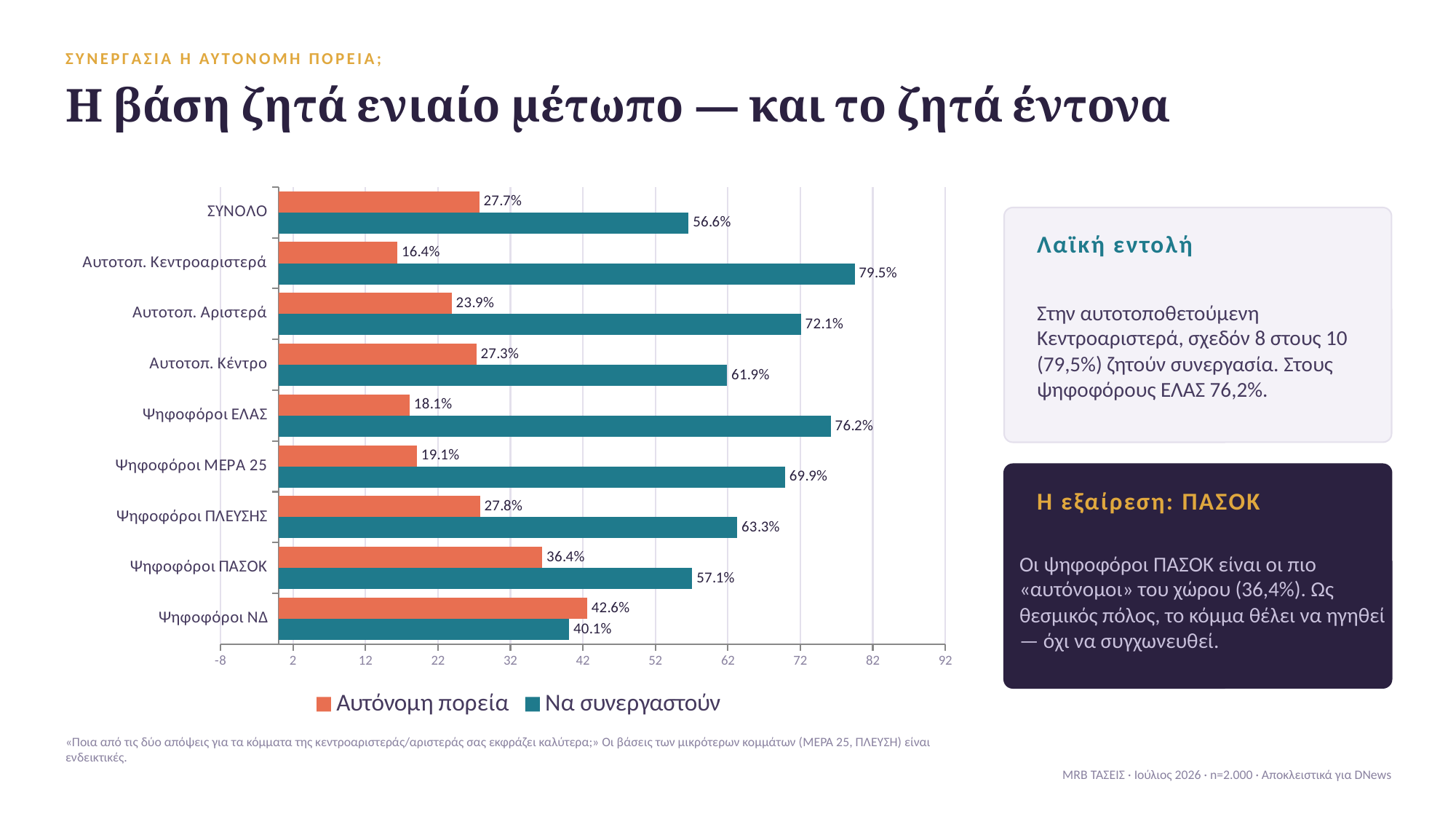
What is the value of 'Αυτόνομη πορεία' for Ψηφοφόροι ΠΑΣΟΚ? 36.4% What is the difference between 'Να συνεργαστούν' and 'Αυτόνομη πορεία' for Ψηφοφόροι ΠΑΣΟΚ? 20.7 percentage points How many categories are shown on the chart? 9 Which category has the highest value for 'Αυτόνομη πορεία'? Ψηφοφόροι ΝΔ What is the value of 'Να συνεργαστούν' for Αυτοτοπ. Κεντροαριστερά? 79.5% Which category has the highest value for 'Να συνεργαστούν'? Αυτοτοπ. Κεντροαριστερά For Ψηφοφόροι ΝΔ, which is larger: 'Αυτόνομη πορεία' or 'Να συνεργαστούν'? Αυτόνομη πορεία Which colour represents the 'Να συνεργαστούν' series in the chart? Teal What is the value of 'Να συνεργαστούν' for ΣΥΝΟΛΟ? 56.6% Which category has the lowest value for 'Αυτόνομη πορεία'? Αυτοτοπ. Κεντροαριστερά What type of chart is shown on the slide? Bar chart How many series does the chart legend list? 2